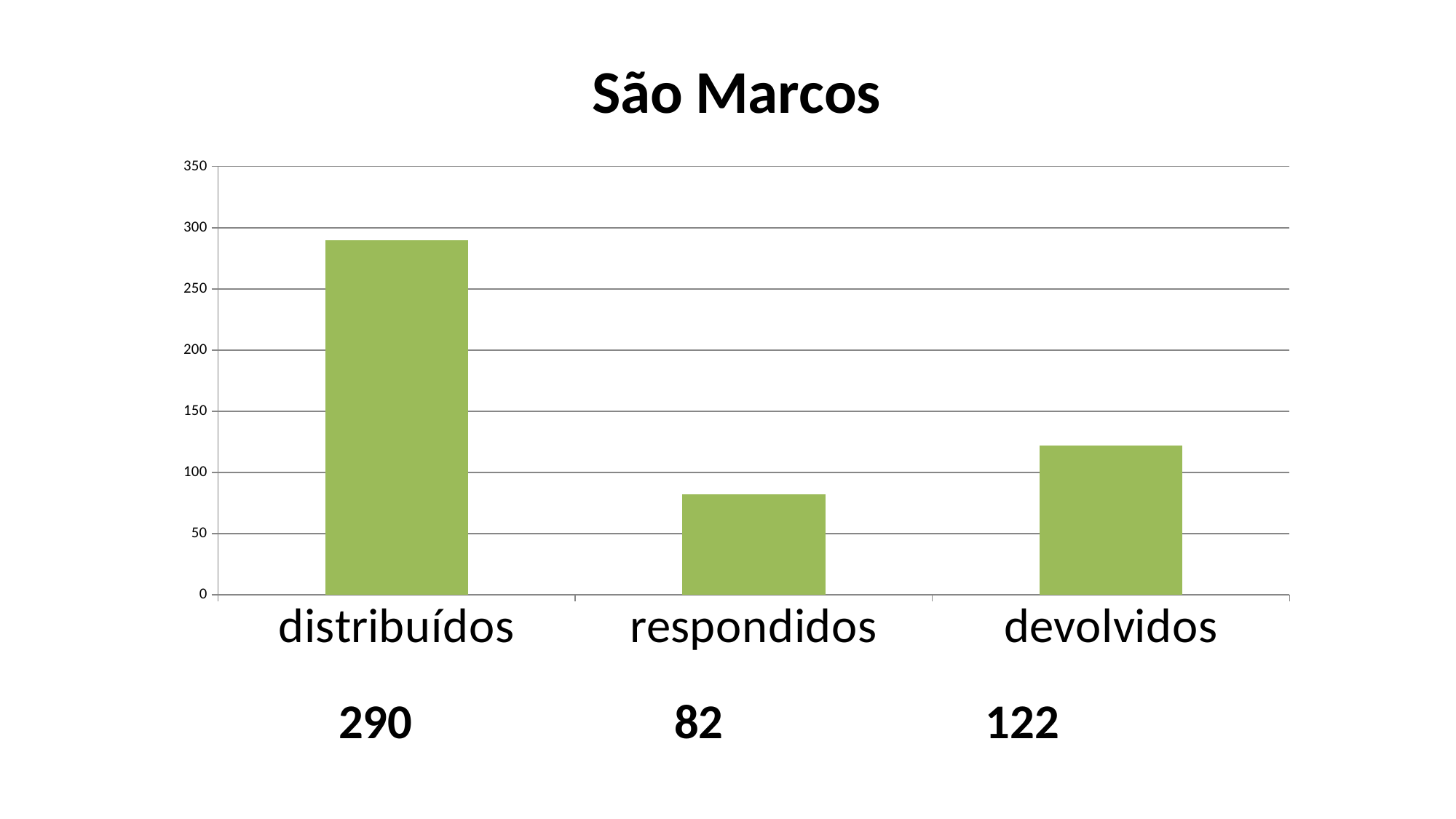
What is the difference between the values for devolvidos and respondidos? 40 What kind of chart is shown on the slide? bar chart What is the difference between the values for distribuídos and devolvidos? 168 Is the value for distribuídos greater or less than 250? greater Which is larger, the value for respondidos or the value for devolvidos? devolvidos What is the value for devolvidos? 122 Which category has the lowest value? respondidos Which category has the highest value? distribuídos What is the title of the chart? São Marcos What is the value for distribuídos? 290 How many categories are shown on the x axis? 3 What is the value for respondidos? 82